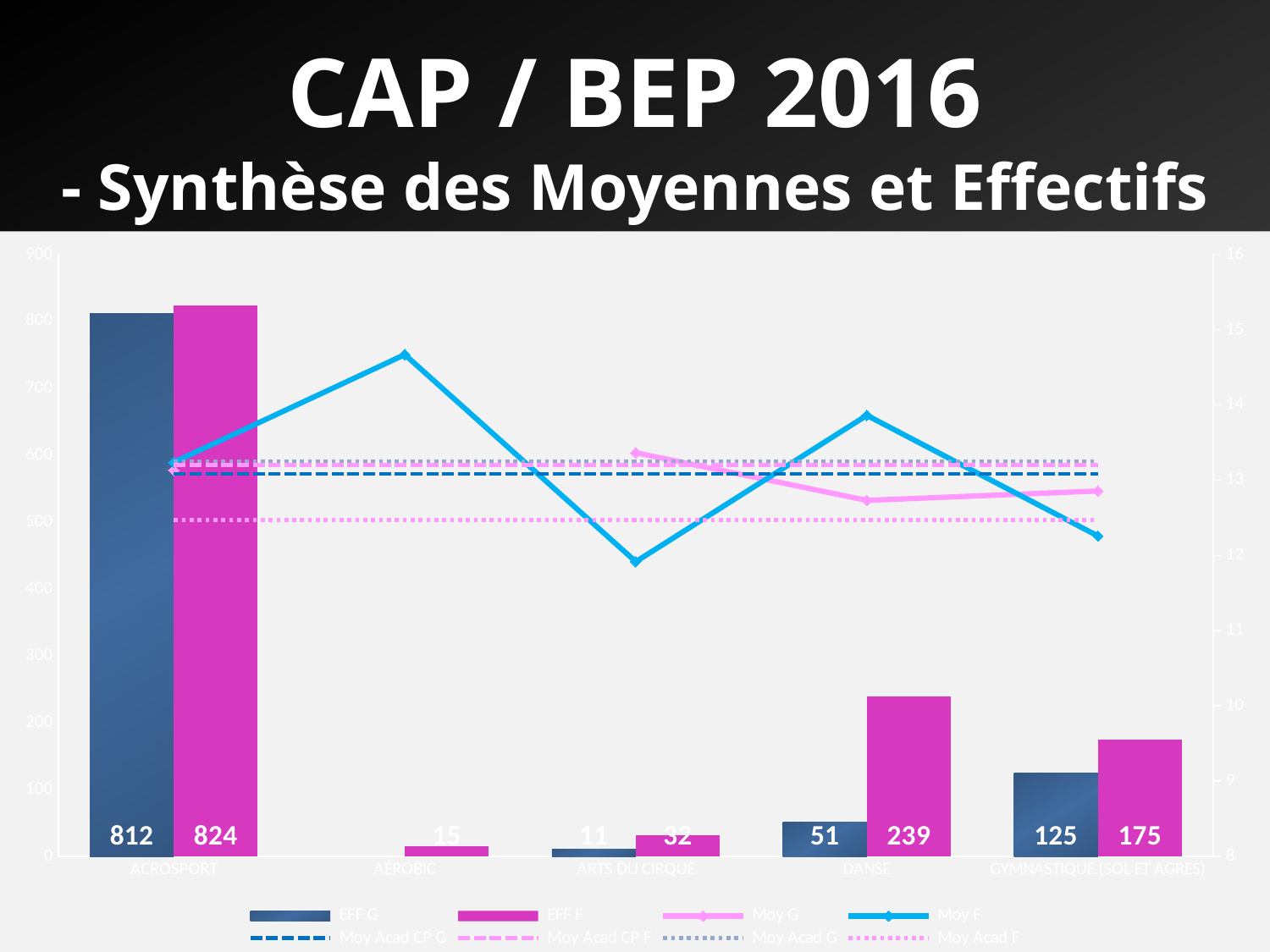
What is the difference between EFF F and EFF G for ACROSPORT? 12 What is the difference between EFF F and EFF G for DANSE? 188 What is the EFF G value for GYMNASTIQUE (SOL ET AGRES)? 125 Which category has the highest EFF F value? ACROSPORT Is the Moy F value for AÉROBIC greater or less than 14 on the right axis? greater Is the Moy F value for GYMNASTIQUE (SOL ET AGRES) greater or less than 13 on the right axis? less Which category has the lowest EFF F value? AÉROBIC How many series does the legend list? 8 What is the EFF F value for AÉROBIC? 15 What is the EFF F value for DANSE? 239 How many categories are shown on the x axis? 5 For ARTS DU CIRQUE, which is larger: EFF G or EFF F? EFF F